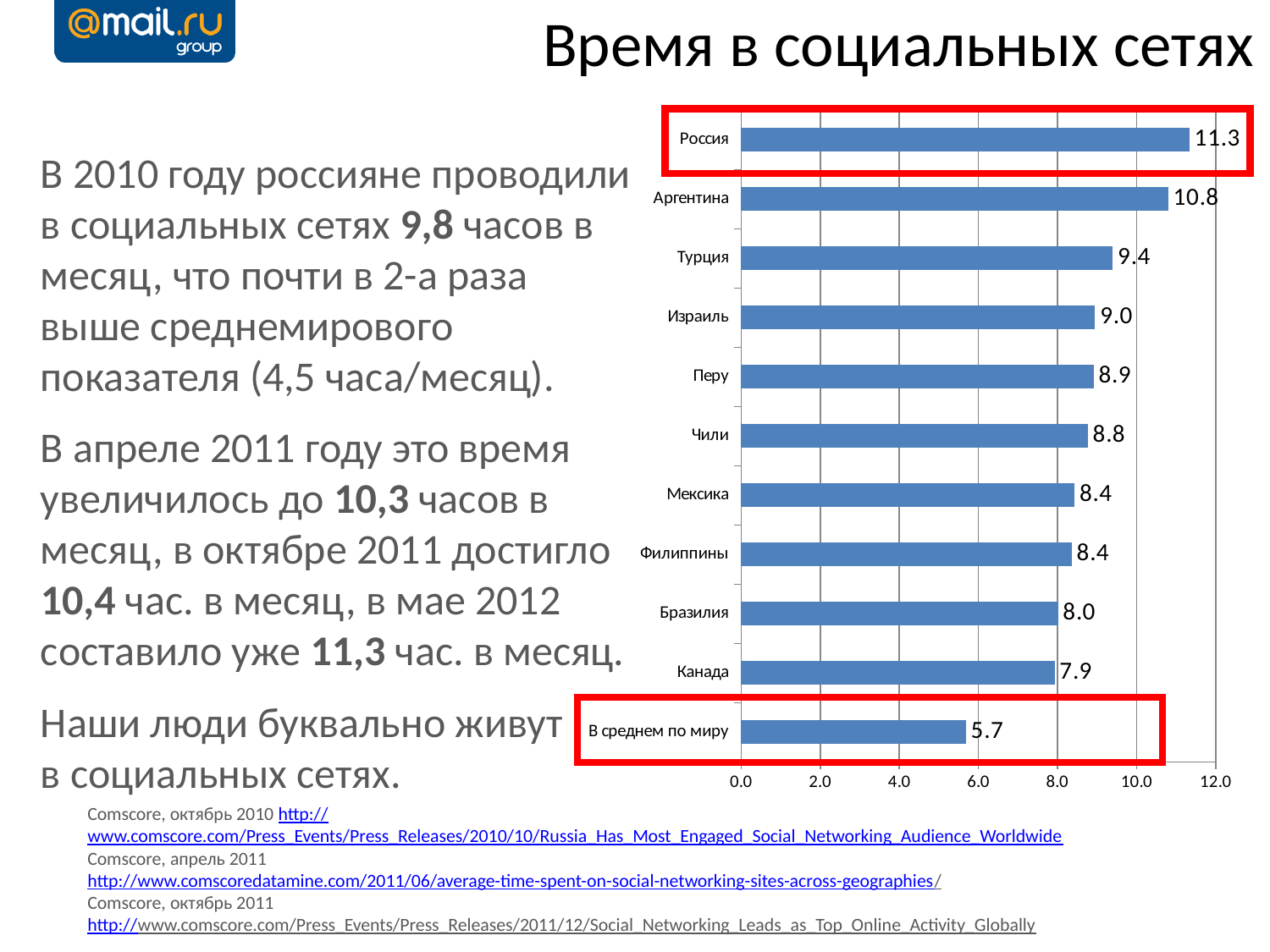
What is the value shown for Канада in the bar chart? 7.9 What is the difference between the values for Россия and В среднем по миру? 5.6 What is the value shown for В среднем по миру in the bar chart? 5.7 How many categories are shown in the bar chart? 11 Which has a larger value, Израиль or Бразилия? Израиль Which category has the lowest value in the bar chart? В среднем по миру What is the value shown for Аргентина in the bar chart? 10.8 Is the value for Турция greater or less than 8.0? greater Which category has the highest value in the bar chart? Россия What is the value shown for Россия in the bar chart? 11.3 What kind of chart is shown on the slide? bar chart What is the difference between the values for Аргентина and Турция? 1.4